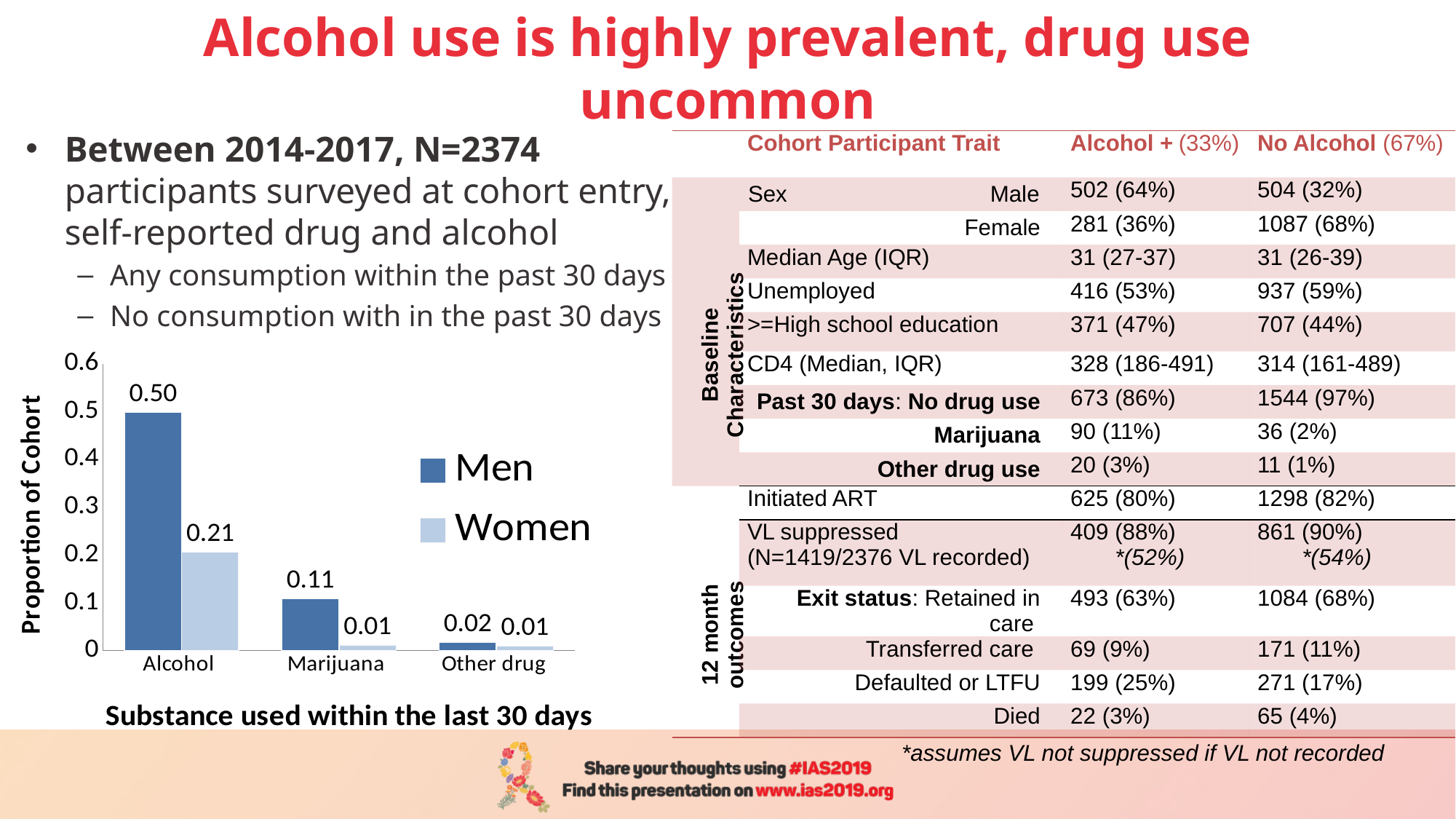
What is the proportion of the cohort for Women who used Alcohol within the last 30 days? 0.21 What is the proportion of the cohort for Men who used Marijuana? 0.11 Which substance has the highest proportion for Men? Alcohol Which is larger, the Men proportion for Marijuana or the Women proportion for Alcohol? Women proportion for Alcohol What is the label of the y axis of the chart? Proportion of Cohort What is the difference between the Men and Women proportions for Alcohol? 0.29 Which substance has the lowest proportion for Men? Other drug How many series does the chart legend list? 2 How many substance categories are shown on the x axis of the chart? 3 What is the proportion of the cohort for Men who used Alcohol within the last 30 days? 0.50 What kind of chart is shown on the slide? Bar chart What is the proportion of the cohort for Women who used Other drug? 0.01